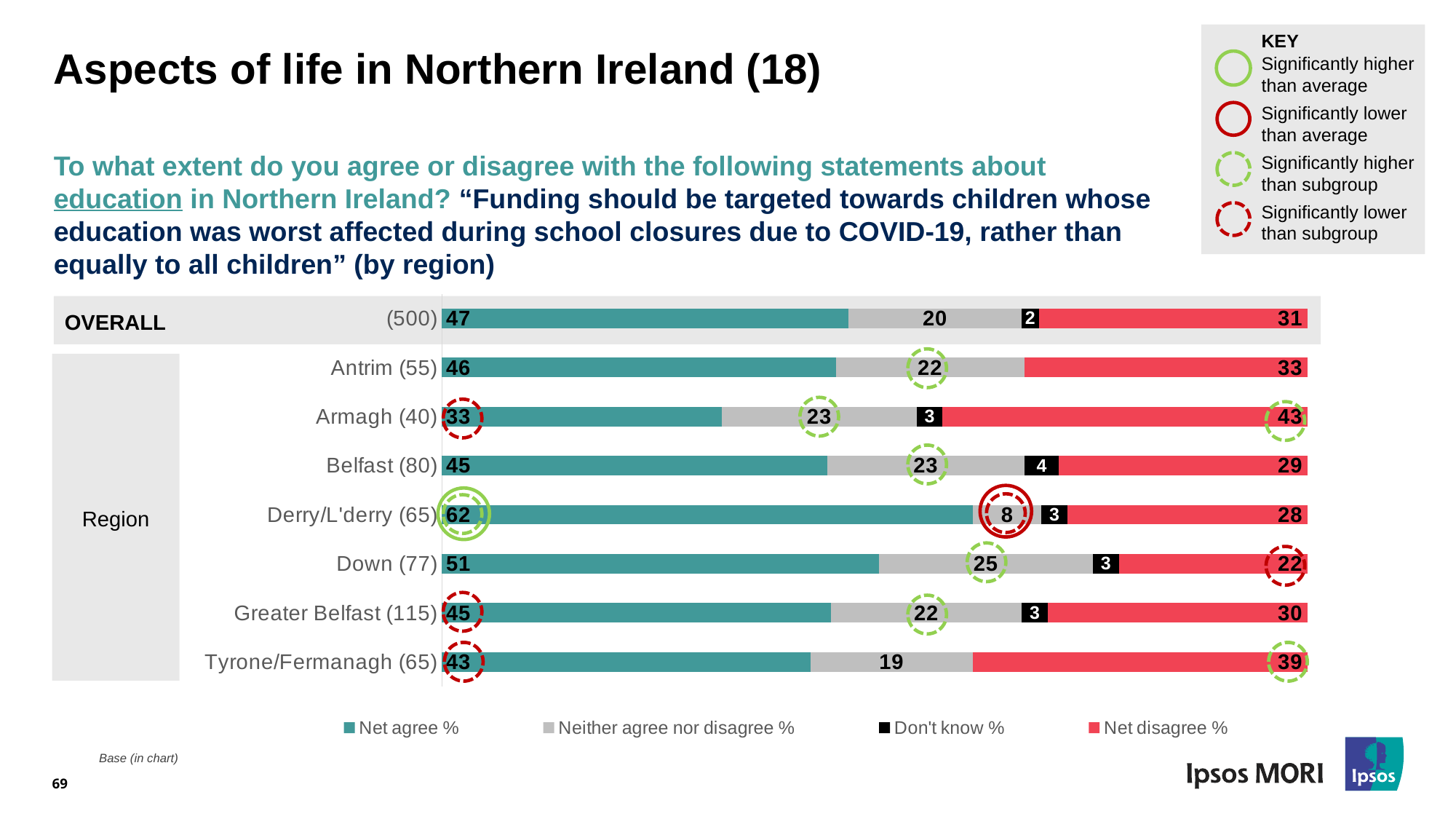
What kind of chart is shown on the slide? Stacked bar chart What is the Neither agree nor disagree % for Down? 25 What is the Net agree % for Derry/L'derry? 62 How many series does the legend list? 4 Which region has the lowest Net agree %? Armagh How much higher is the Net agree % for Derry/L'derry than for OVERALL? 15 Which region has the highest Net agree %? Derry/L'derry Which region has the lowest Net disagree %? Down What is the Net disagree % for Armagh? 43 Which has a larger Net agree %, Down or Antrim? Down Which region has the highest Net disagree %? Armagh What is the Don't know % for the OVERALL row? 2